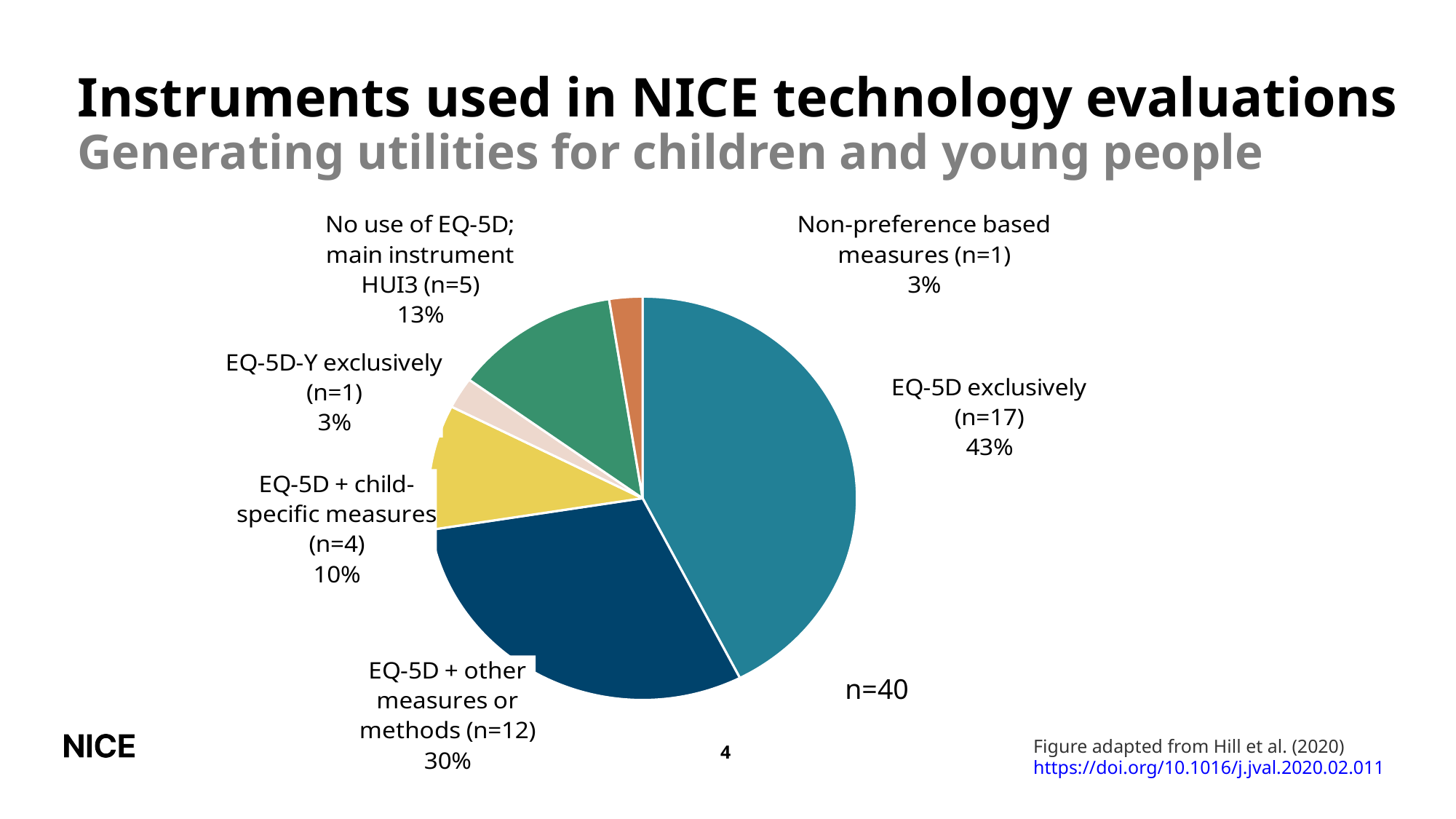
Which category has the largest slice of the pie? EQ-5D exclusively How many slices does the pie chart have? 6 What is the n value for 'EQ-5D-Y exclusively'? n=1 What kind of chart is shown on the slide? Pie chart What is the n value for 'EQ-5D + other measures or methods'? n=12 What is the total n shown for the pie chart? n=40 What is the difference in percentage points between 'EQ-5D exclusively' and 'EQ-5D + other measures or methods'? 13 What percentage share does 'No use of EQ-5D; main instrument HUI3' have? 13% What is the subtitle of the slide? Generating utilities for children and young people Which is larger: 'EQ-5D + child-specific measures' or 'No use of EQ-5D; main instrument HUI3'? No use of EQ-5D; main instrument HUI3 What percentage of the pie is 'EQ-5D exclusively'? 43% What percentage share does 'Non-preference based measures' have? 3%